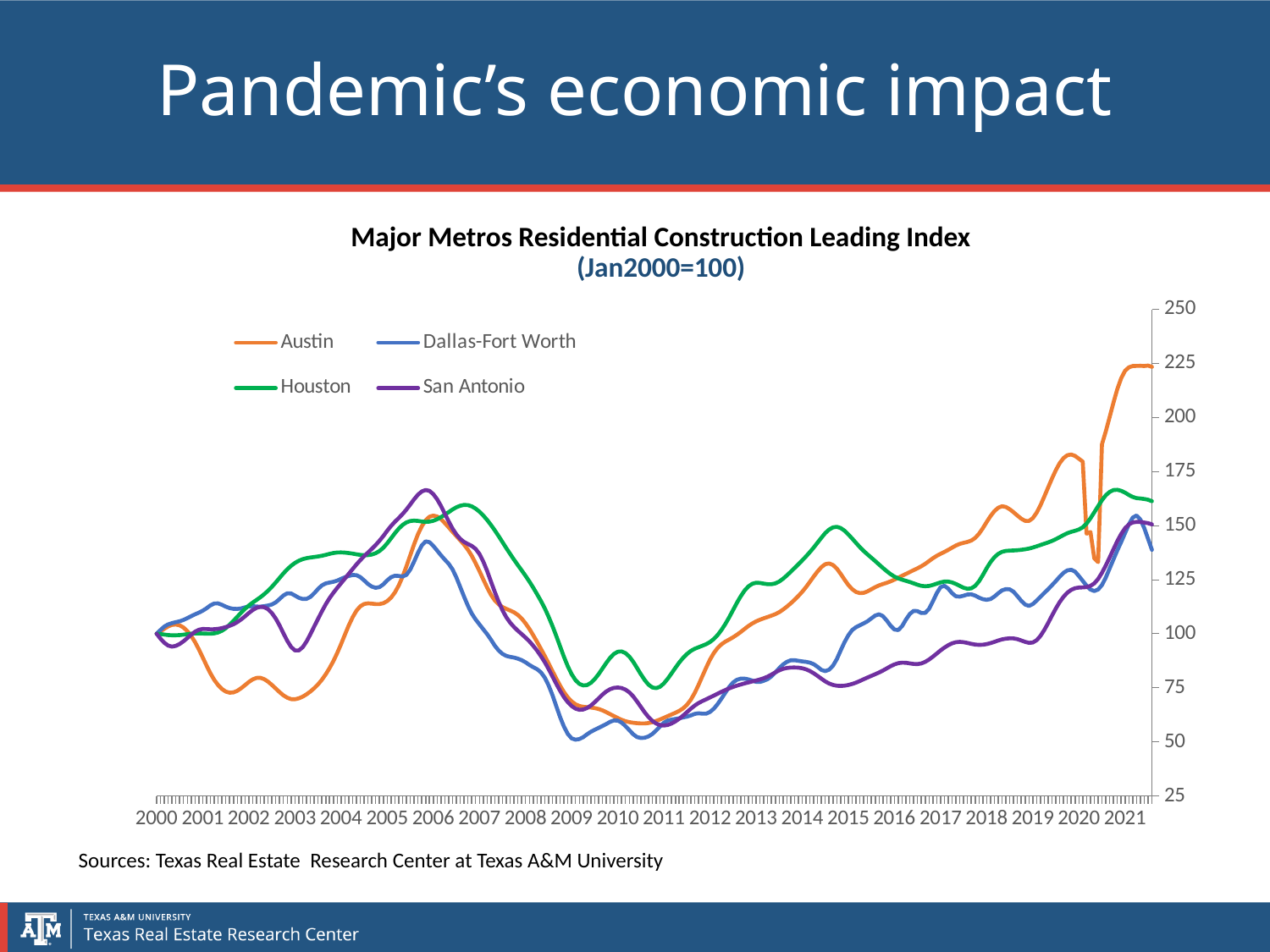
Is the value for Houston in 2015 greater or less than 125? greater Which series is higher at the end of 2021, Austin or Houston? Austin How many series does the legend list? 4 Which series reaches the highest value on the chart? Austin Is the value for San Antonio in 2015 greater or less than 100? less Does the Austin series rise or fall between 2020 and the end of 2021? rise Which metros are listed in the chart's legend? Austin, Dallas-Fort Worth, Houston, San Antonio Is the value for Dallas-Fort Worth in 2009 greater or less than 75? less How many year labels are shown on the x axis? 22 What base period is the index set to 100, according to the chart subtitle? Jan2000=100 What kind of chart is shown on the slide? line chart